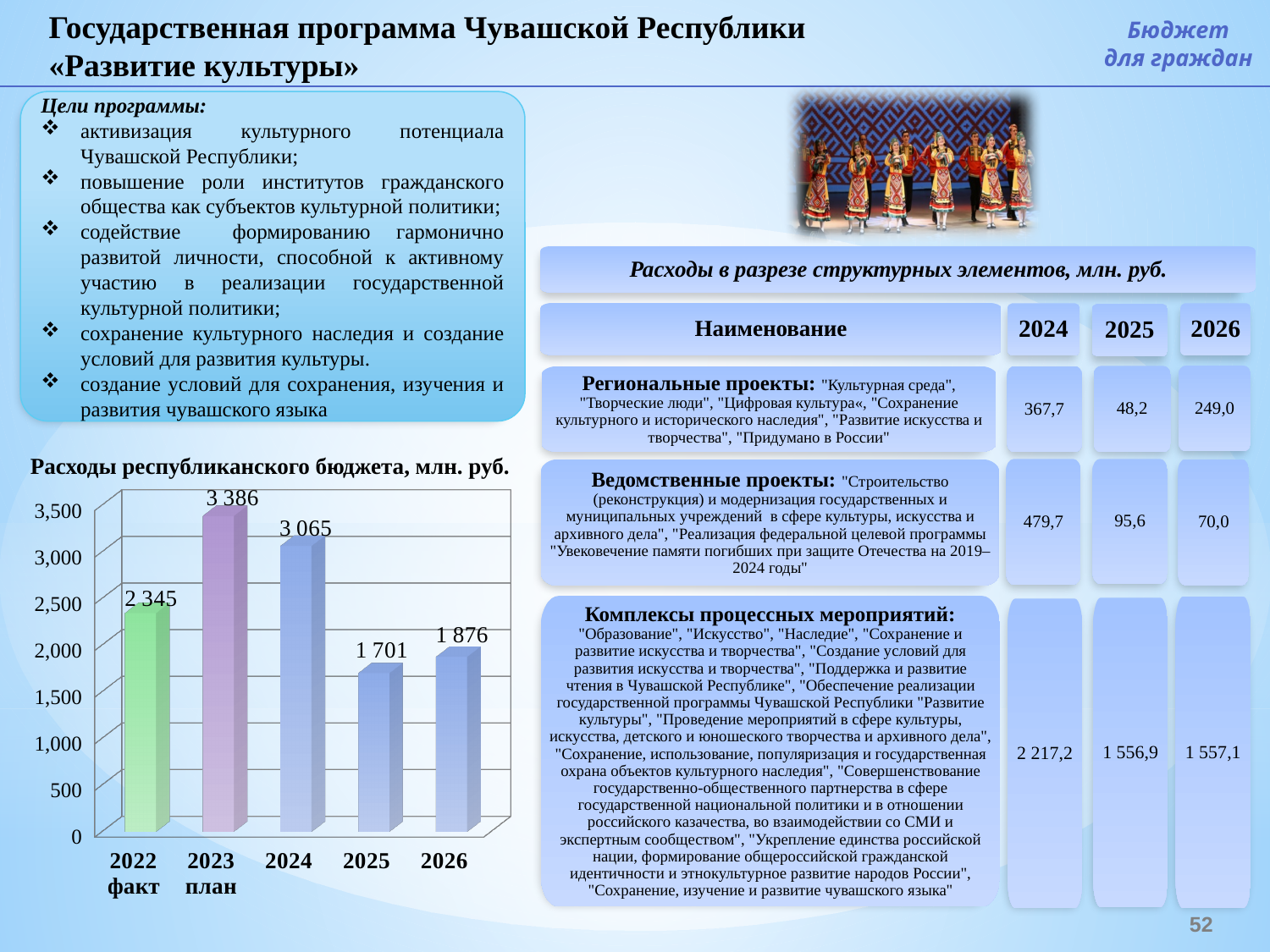
In the chart 'Расходы республиканского бюджета, млн. руб.', do the values rise or fall from 2023 to 2025? fall Which year has the lowest value in the chart 'Расходы республиканского бюджета, млн. руб.'? 2025 What is the difference between the 2023 and 2024 values in the chart 'Расходы республиканского бюджета, млн. руб.'? 321 What is the difference between the 2026 and 2025 values in the chart 'Расходы республиканского бюджета, млн. руб.'? 175 What kind of chart is 'Расходы республиканского бюджета, млн. руб.'? bar chart In the chart 'Расходы республиканского бюджета, млн. руб.', is the value for 2024 greater or less than 3,000? greater In the chart 'Расходы республиканского бюджета, млн. руб.', which is larger: the value for 2024 or the value for 2026? 2024 What is the value for 2022 (факт) in the chart 'Расходы республиканского бюджета, млн. руб.'? 2 345 What is the value for 2023 (план) in the chart 'Расходы республиканского бюджета, млн. руб.'? 3 386 What is the value for 2025 in the chart 'Расходы республиканского бюджета, млн. руб.'? 1 701 How many bars are shown in the chart 'Расходы республиканского бюджета, млн. руб.'? 5 Which year has the highest value in the chart 'Расходы республиканского бюджета, млн. руб.'? 2023